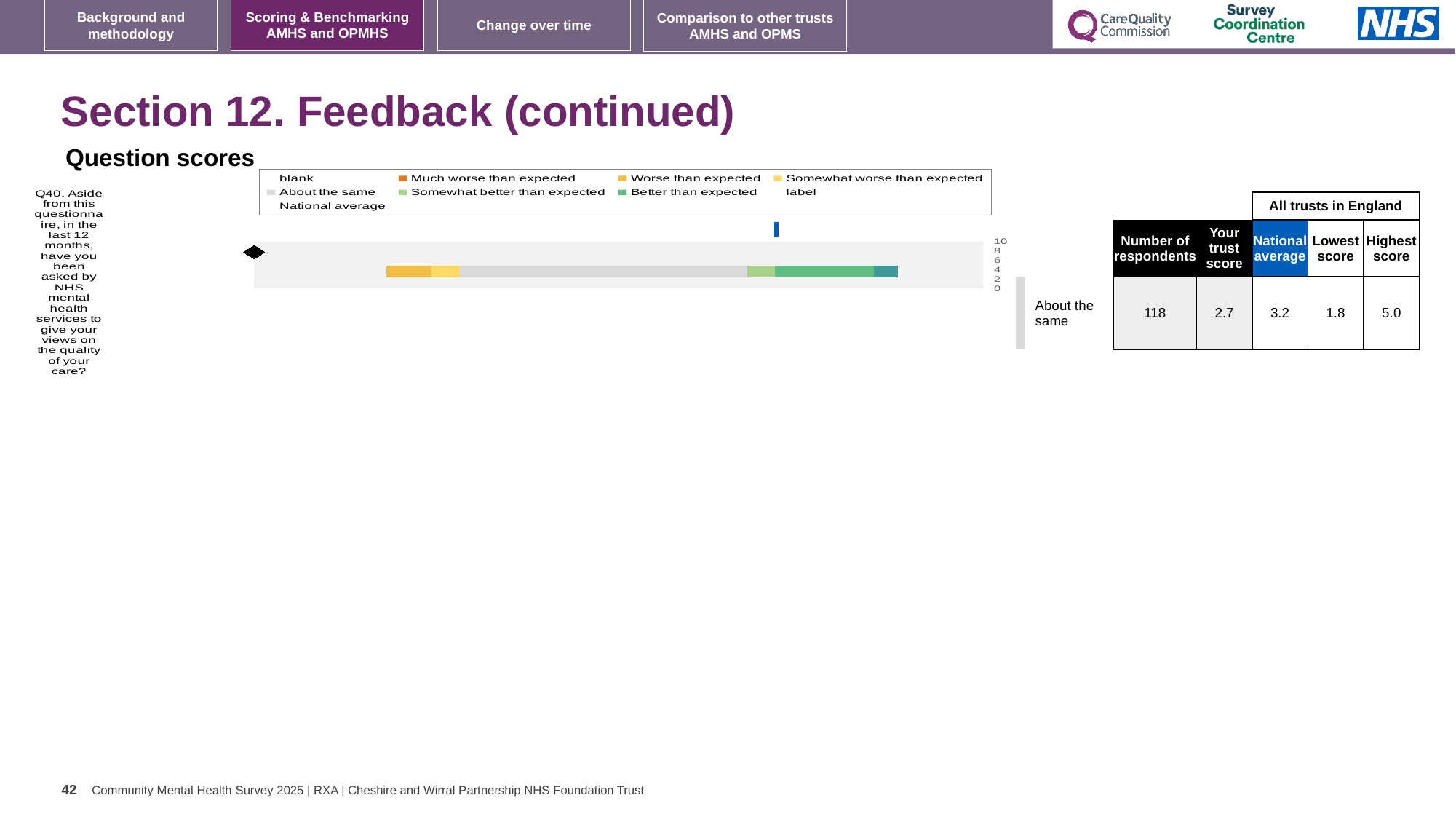
Is the trust score for Q40 higher or lower than the national average? Lower What is the difference between the highest score and the lowest score for Q40 in the table? 3.2 In the table beside the chart, what is the national average for Q40? 3.2 How many survey questions are plotted in the chart? 1 In the table beside the chart, what is the highest score among all trusts in England for Q40? 5.0 Which question number is plotted in the chart? Q40 In the table beside the chart, what is the lowest score among all trusts in England for Q40? 1.8 What kind of chart is shown under 'Question scores'? Stacked bar chart What colour does the legend use for 'Better than expected'? Green In the table beside the chart, what is the number of respondents for Q40? 118 In the table beside the chart, what is 'Your trust score' for Q40? 2.7 What comparison category is shown for Q40 next to the chart? About the same